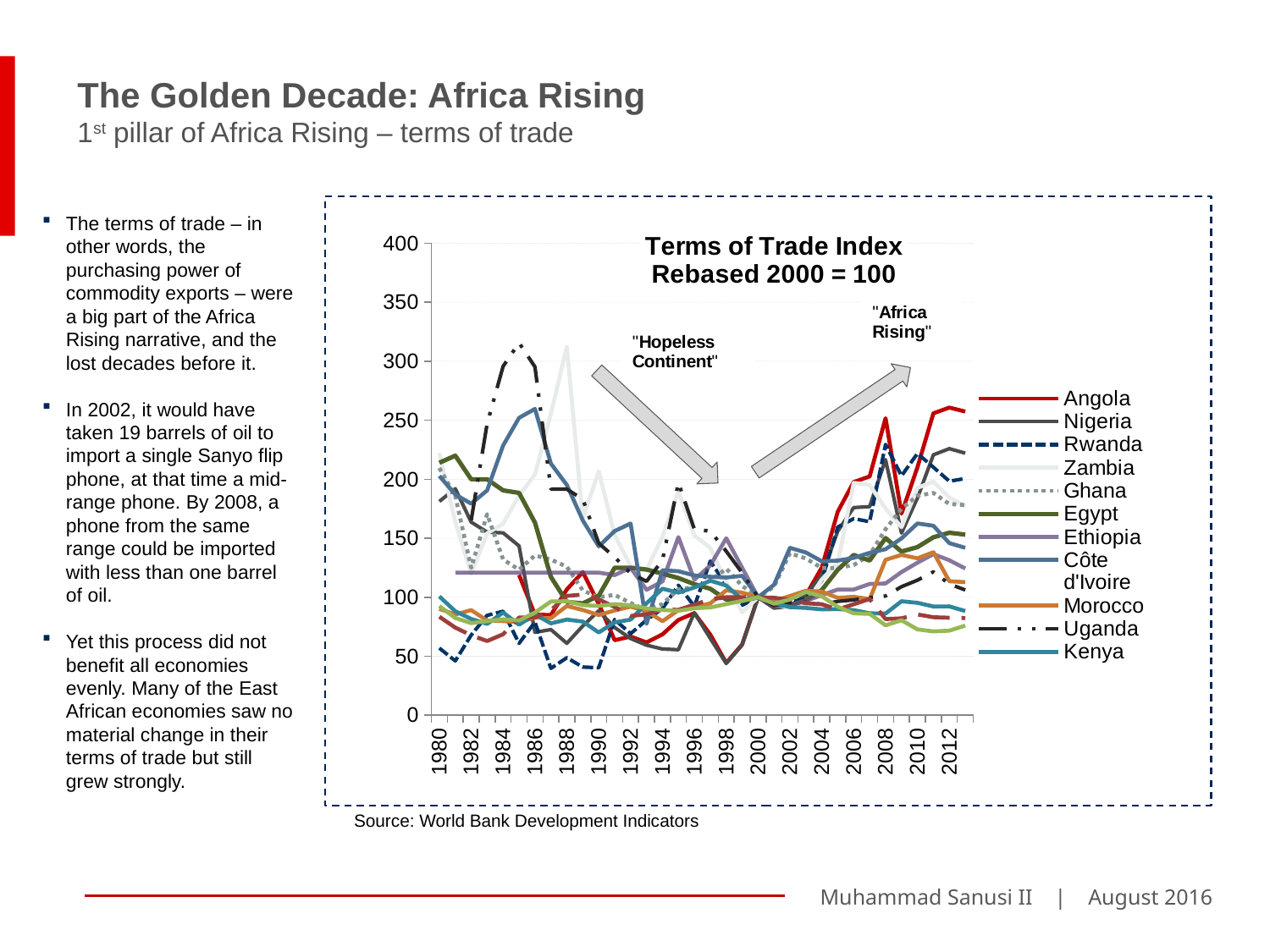
Which country has the lowest Terms of Trade Index value in 1988? Rwanda What is the value of the Terms of Trade Index for every country in the year 2000? 100 Is the value for Kenya in 2012 greater or less than 100? less Which country has the highest Terms of Trade Index value in 2012? Angola How many series does the legend of the Terms of Trade Index chart list? 11 What is the title of the chart? Terms of Trade Index Rebased 2000 = 100 Which is larger in 2012, the value for Angola or the value for Kenya? Angola What kind of chart is shown on the slide? line chart Does the Terms of Trade Index for Angola rise or fall between 2000 and 2008? rise Is the value for Angola in 2012 greater or less than 250? greater Is the value for Zambia in 1988 greater or less than 300? greater